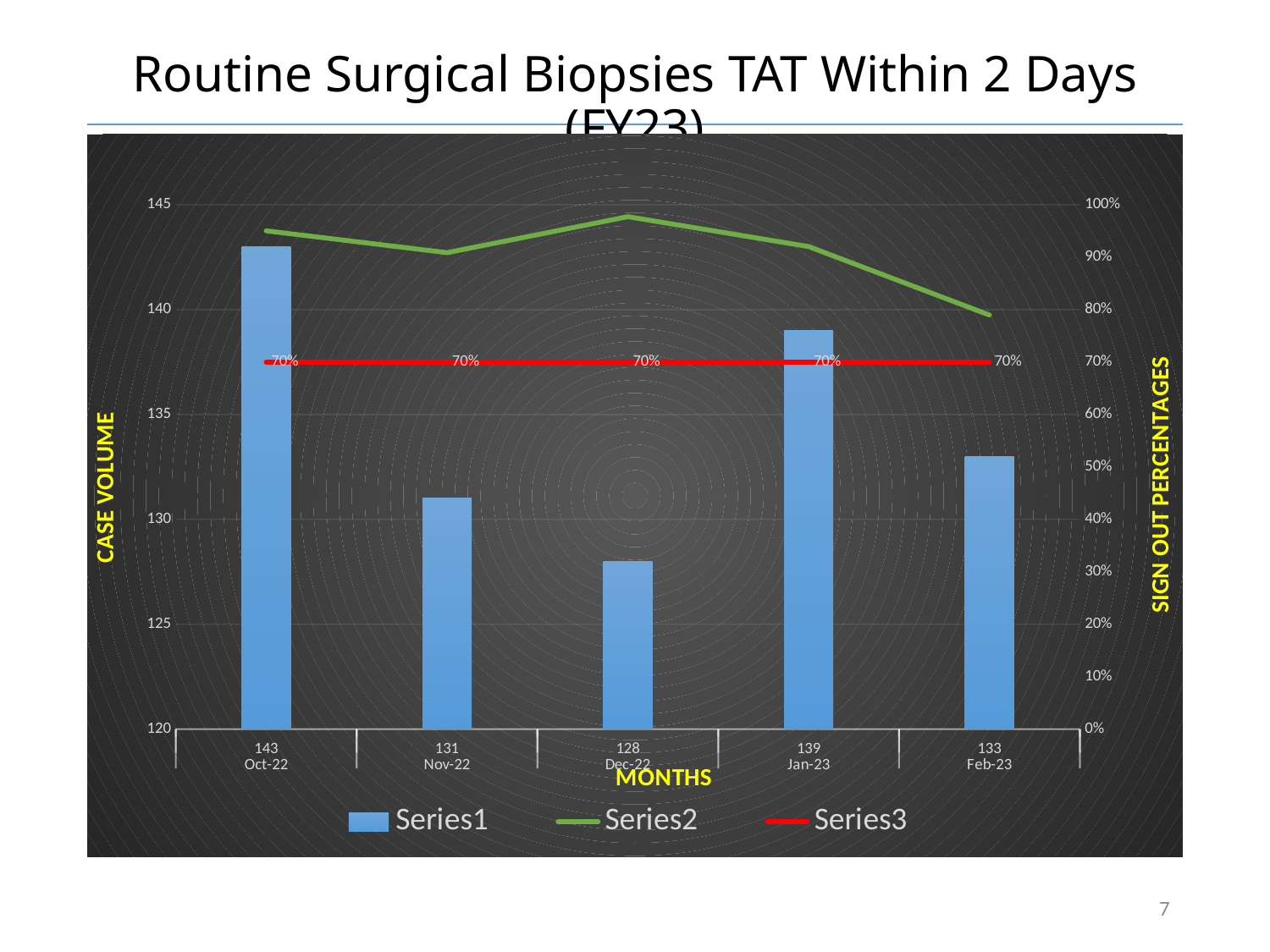
What is the case volume for Dec-22? 128 Which month has the lowest case volume? Dec-22 Which month has the larger case volume, Jan-23 or Nov-22? Jan-23 What kind of chart is shown on the slide? Combined bar and line chart What is the difference in case volume between Oct-22 and Dec-22? 15 Is the Series2 (green line) value for Feb-23 greater or less than 90%? less Does the Series2 (green line) value rise or fall from Jan-23 to Feb-23? fall What value does Series3 (the red line) show for Nov-22? 70% How many series does the legend list? 3 How many months are shown on the x axis? 5 Which month has the highest case volume? Oct-22 What is the case volume for Oct-22? 143